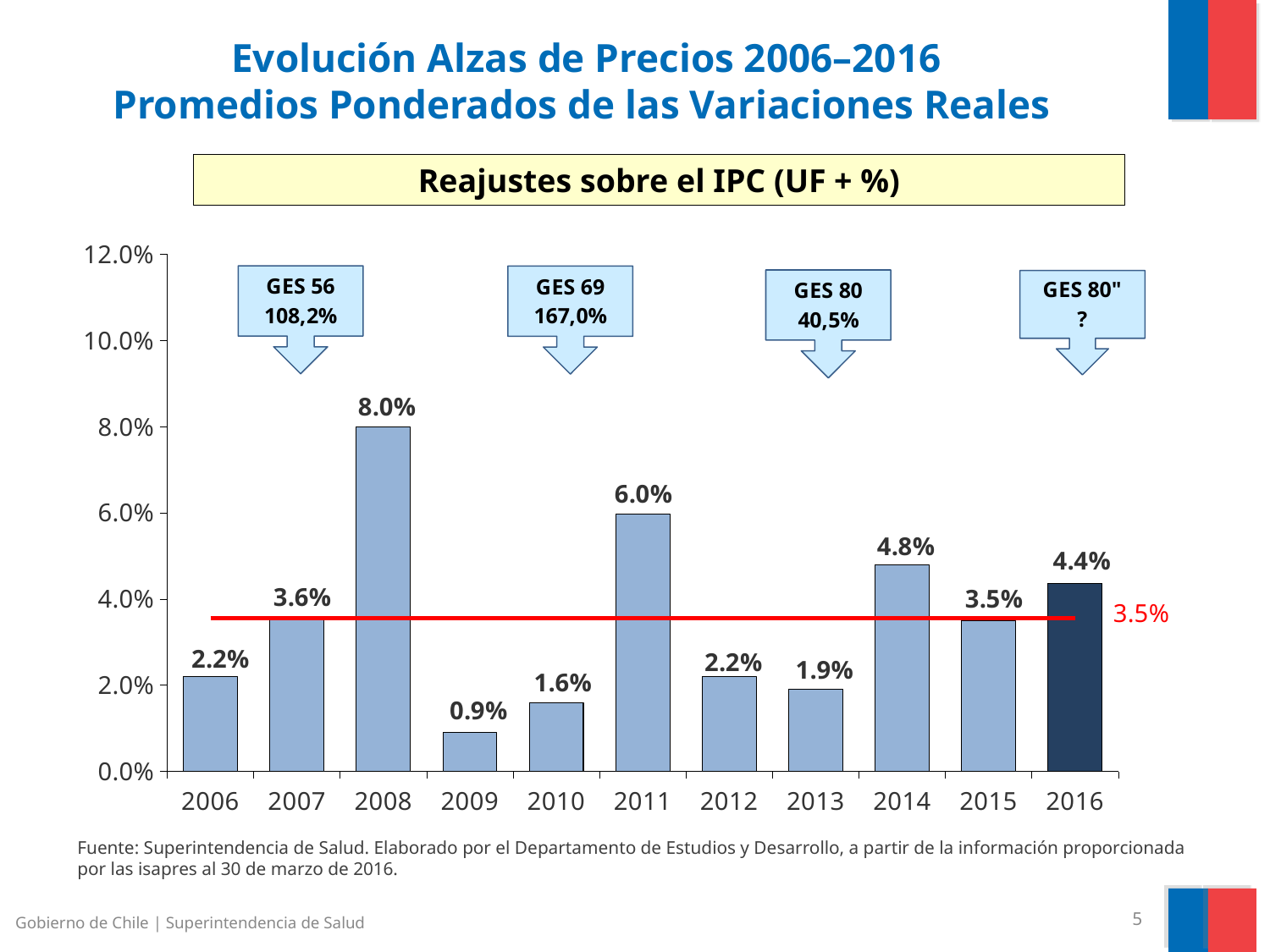
Which is larger, the value for 2007 or the value for 2010? 2007 What value is marked by the red horizontal line? 3.5% What kind of chart is this? Bar chart What is the value for 2008? 8.0% How many years are shown on the x axis? 11 Which year has the lowest value? 2009 What is the difference between the values for 2008 and 2011? 2.0% What is the value for 2016? 4.4% What is the difference between the values for 2014 and 2015? 1.3% What is the value for 2009? 0.9% Do the values rise or fall from 2013 to 2014? Rise Which year has the highest value? 2008